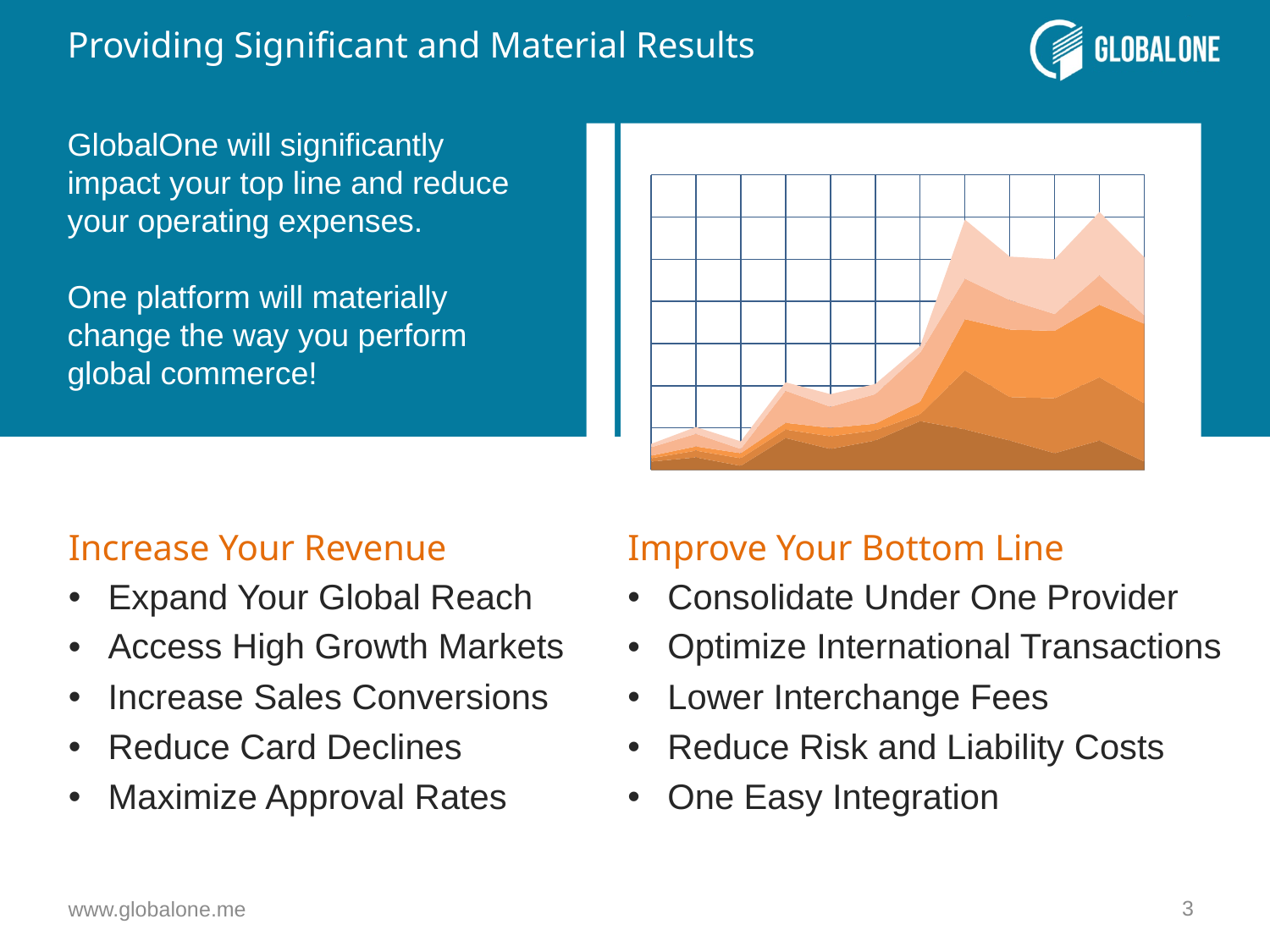
What colour family are the shaded areas in the chart? orange What kind of chart is shown on the slide? area chart Do the values in the area chart generally rise or fall from left to right? rise Is the area chart stacked with multiple layers or a single layer? multiple stacked layers